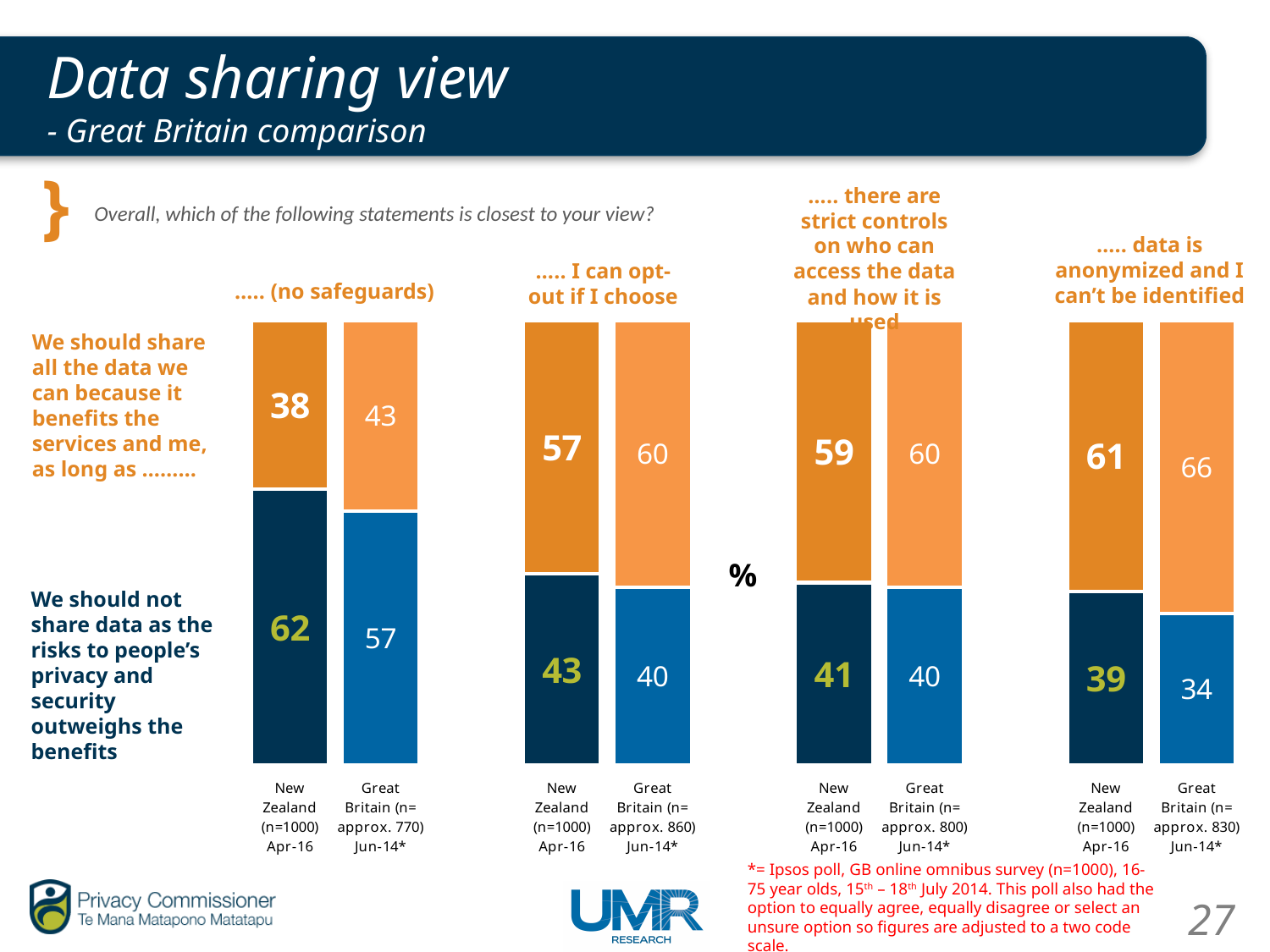
In the "data is anonymized and I can't be identified" chart, which is larger for "We should share all the data": New Zealand or Great Britain? Great Britain In the "(no safeguards)" chart, what is the value for "We should not share data" for Great Britain? 57 In the "there are strict controls" chart, what is the difference between the New Zealand and Great Britain values for "We should share all the data"? 1 In the "(no safeguards)" chart, which is larger for "We should not share data": New Zealand or Great Britain? New Zealand What kind of chart is used on this slide? Stacked bar chart What is the sample size shown for Great Britain in the "(no safeguards)" chart? approx. 770 In the "data is anonymized and I can't be identified" chart, what is the value for "We should not share data" for Great Britain? 34 Across the four charts, which has the highest New Zealand value for "We should share all the data"? data is anonymized and I can't be identified In the "I can opt-out if I choose" chart, what is the total of the New Zealand stacked bar? 100 In the "I can opt-out if I choose" chart, what is the value for "We should share all the data" for Great Britain? 60 In the "(no safeguards)" chart, what is the value for "We should share all the data" for New Zealand? 38 How many bars are in the "there are strict controls" chart? 2